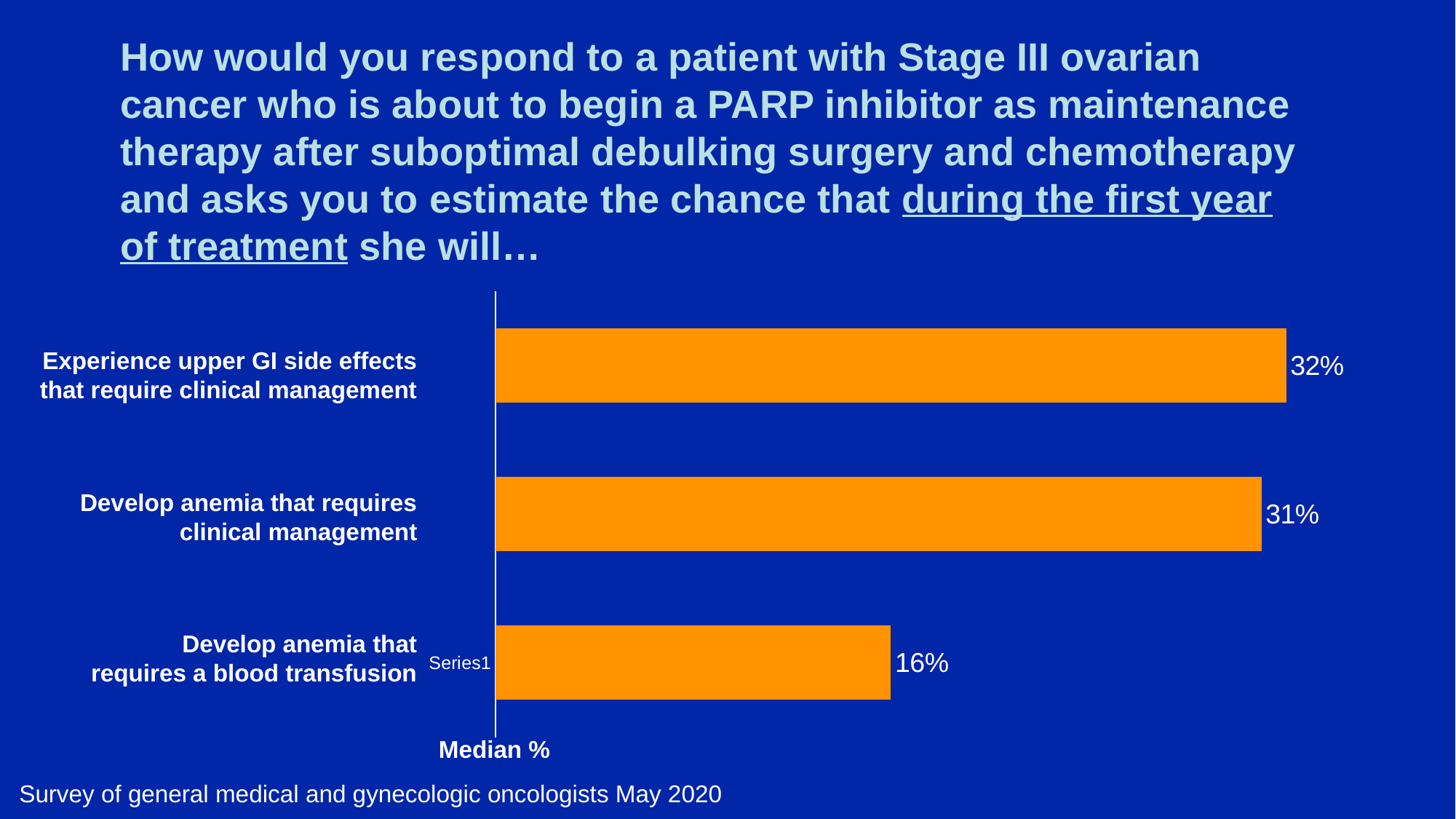
What colour are the bars in the chart? Orange What is the difference in median % between 'Develop anemia that requires clinical management' and 'Develop anemia that requires a blood transfusion'? 15% Which is larger: the median % for 'Develop anemia that requires clinical management' or for 'Develop anemia that requires a blood transfusion'? Develop anemia that requires clinical management What is the label shown below the chart's axis? Median % How many categories are shown in the chart? 3 Which category has the highest median %? Experience upper GI side effects that require clinical management What is the median % for 'Develop anemia that requires clinical management'? 31% What kind of chart is shown on the slide? Bar chart Which category has the lowest median %? Develop anemia that requires a blood transfusion What is the median % for 'Develop anemia that requires a blood transfusion'? 16% What is the median % for 'Experience upper GI side effects that require clinical management'? 32% What is the difference in median % between 'Experience upper GI side effects that require clinical management' and 'Develop anemia that requires a blood transfusion'? 16%